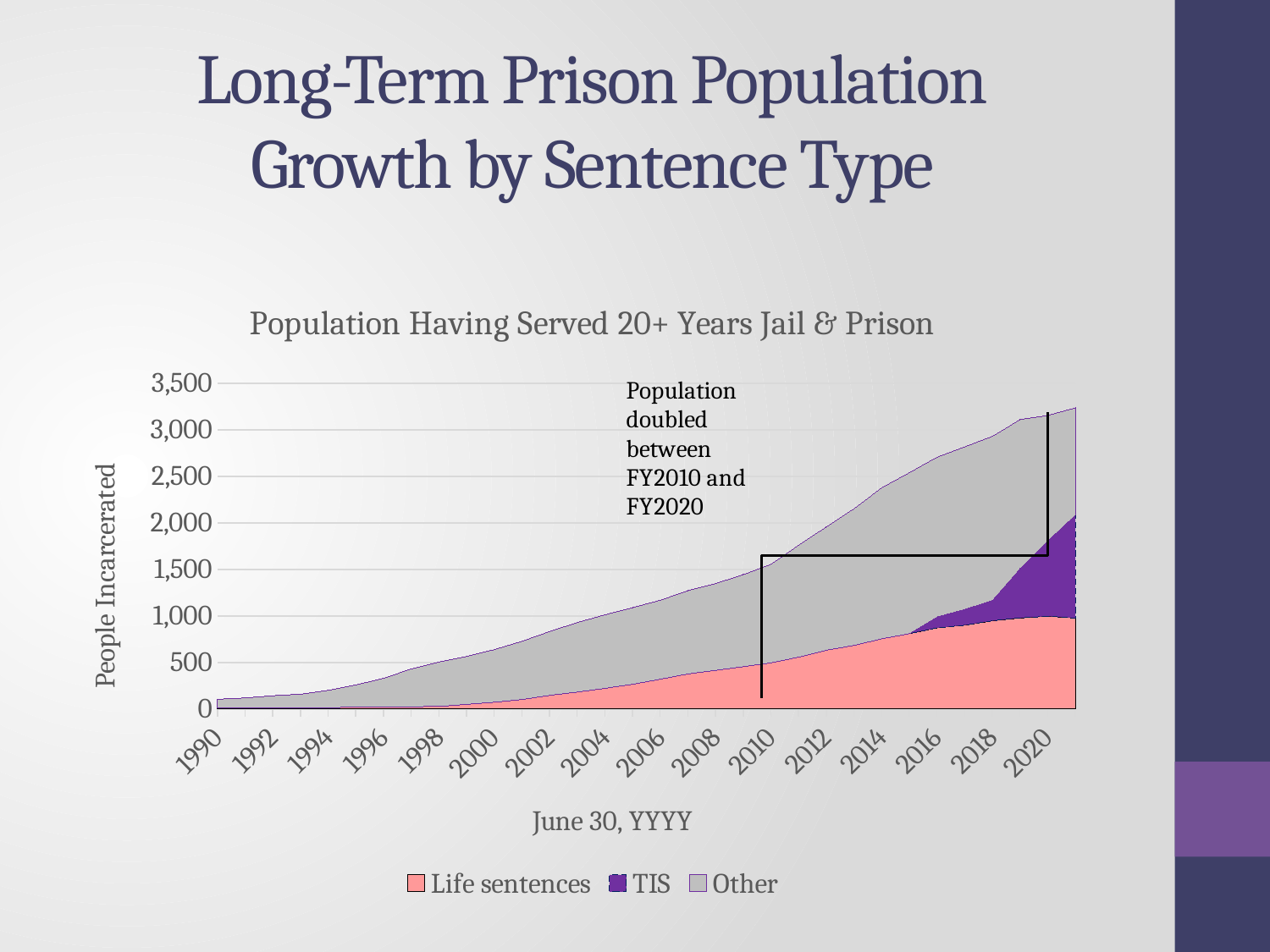
Does the total population having served 20+ years rise or fall from 1990 to 2020? Rise How many year labels are shown on the x axis? 16 Is the total population in 2010 greater or less than 1,000? greater Is the total population in 1990 greater or less than 500? less Is the total population in 2020 greater or less than 3,000? greater What is the title of the chart? Population Having Served 20+ Years Jail & Prison How many series does the legend list? 3 What are the three series named in the legend? Life sentences, TIS, Other What kind of chart is shown on the slide? Stacked area chart Which series has the larger value in 2020, Life sentences or TIS? Life sentences